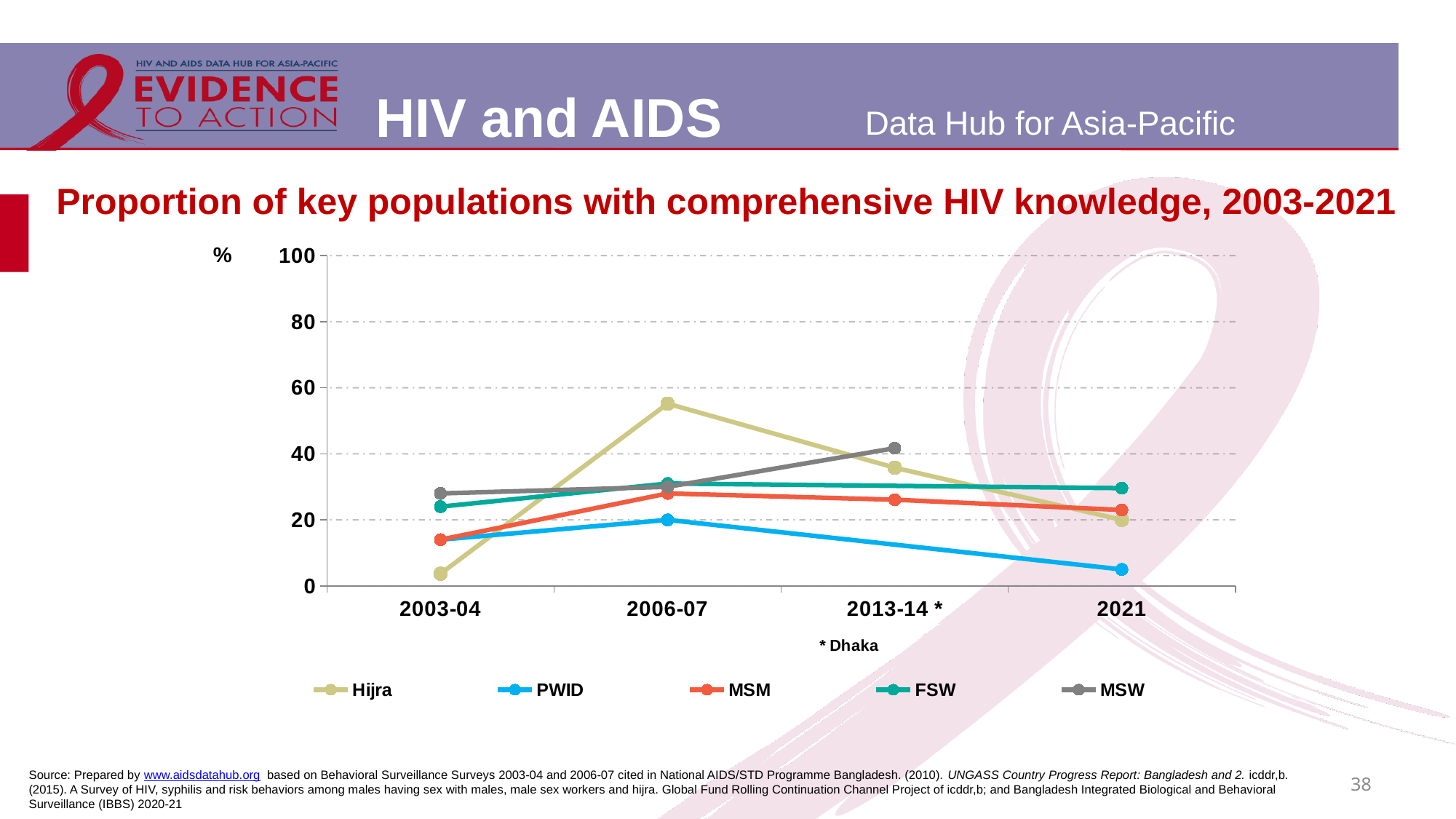
Which key population has the lowest value in 2021? PWID Is the value for Hijra in 2003-04 greater or less than 20? less Which key population has the highest value in 2013-14? MSW How many time points are shown on the x axis? 4 Which key population has the highest value in 2006-07? Hijra What does the asterisk next to 2013-14 on the x axis refer to? Dhaka Is the value for Hijra in 2006-07 greater or less than 40? greater Does the PWID line rise or fall from 2006-07 to 2021? fall In 2013-14, which is larger: the value for MSW or the value for Hijra? MSW What kind of chart is shown on the slide? line chart Is the value for FSW in 2021 greater or less than 20? greater How many series does the legend list? 5